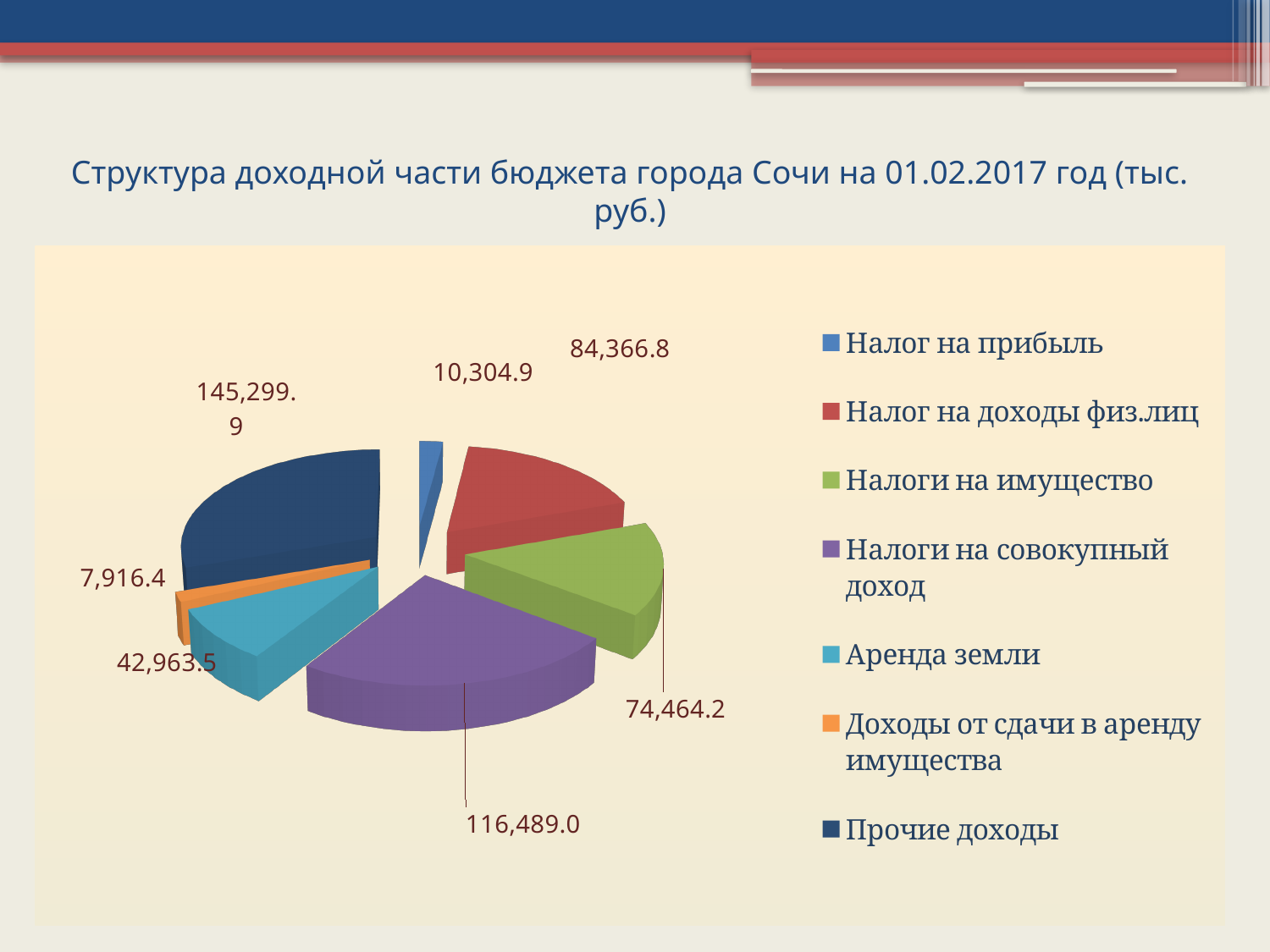
What type of chart is shown on the slide? Pie chart What is the value for Налоги на совокупный доход? 116,489.0 What is the title of the chart? Структура доходной части бюджета города Сочи на 01.02.2017 год (тыс. руб.) What is the difference between Прочие доходы and Налоги на совокупный доход? 28,810.9 Which category has the smallest value? Доходы от сдачи в аренду имущества What is the value for Аренда земли? 42,963.5 Which category has the largest value? Прочие доходы What is the difference between Налог на доходы физ.лиц and Налоги на имущество? 9,902.6 What is the value for Доходы от сдачи в аренду имущества? 7,916.4 What is the value for Прочие доходы? 145,299.9 Which is larger, Налог на прибыль or Аренда земли? Аренда земли How many categories does the pie chart have? 7